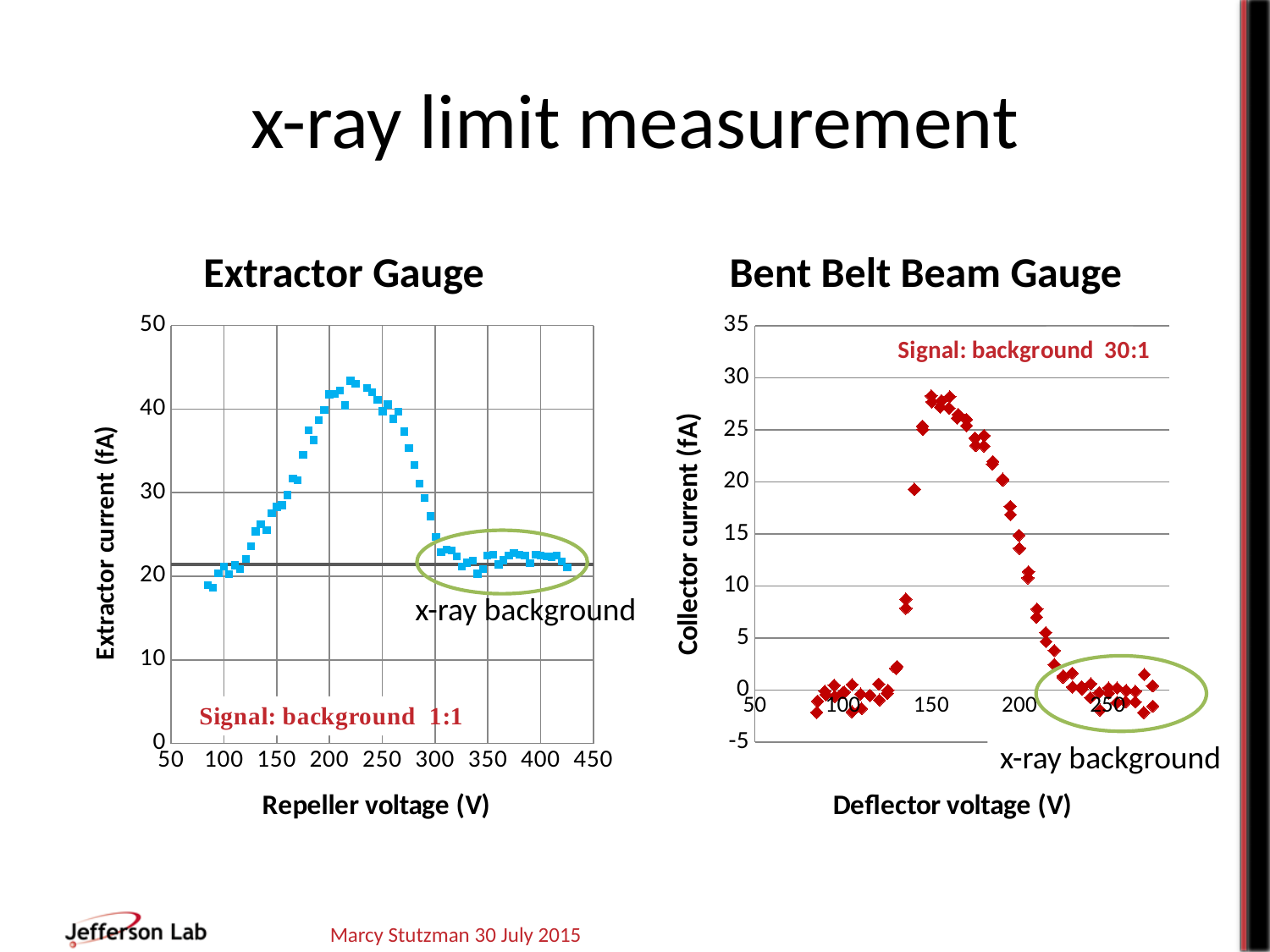
In the Extractor Gauge chart, is the extractor current higher at a repeller voltage of 200 V or at 400 V? 200 V What kind of chart is the Bent Belt Beam Gauge chart? scatter chart What is the x-axis title of the Extractor Gauge chart? Repeller voltage (V) In the Extractor Gauge chart, is the extractor current at a repeller voltage of 100 V greater or less than 30 fA? less In the Extractor Gauge chart, is the extractor current at a repeller voltage of 200 V greater or less than 30 fA? greater In the Bent Belt Beam Gauge chart, is the collector current at a deflector voltage of 250 V greater or less than 10 fA? less In the Bent Belt Beam Gauge chart, does the collector current rise or fall as the deflector voltage increases from 150 V to 200 V? fall What signal-to-background ratio is stated on the Bent Belt Beam Gauge chart? 30:1 In the Extractor Gauge chart, does the extractor current rise or fall as the repeller voltage increases from 100 V to 200 V? rise What kind of chart is the Extractor Gauge chart? scatter chart In the Extractor Gauge chart, does the extractor current rise or fall as the repeller voltage increases from 250 V to 300 V? fall